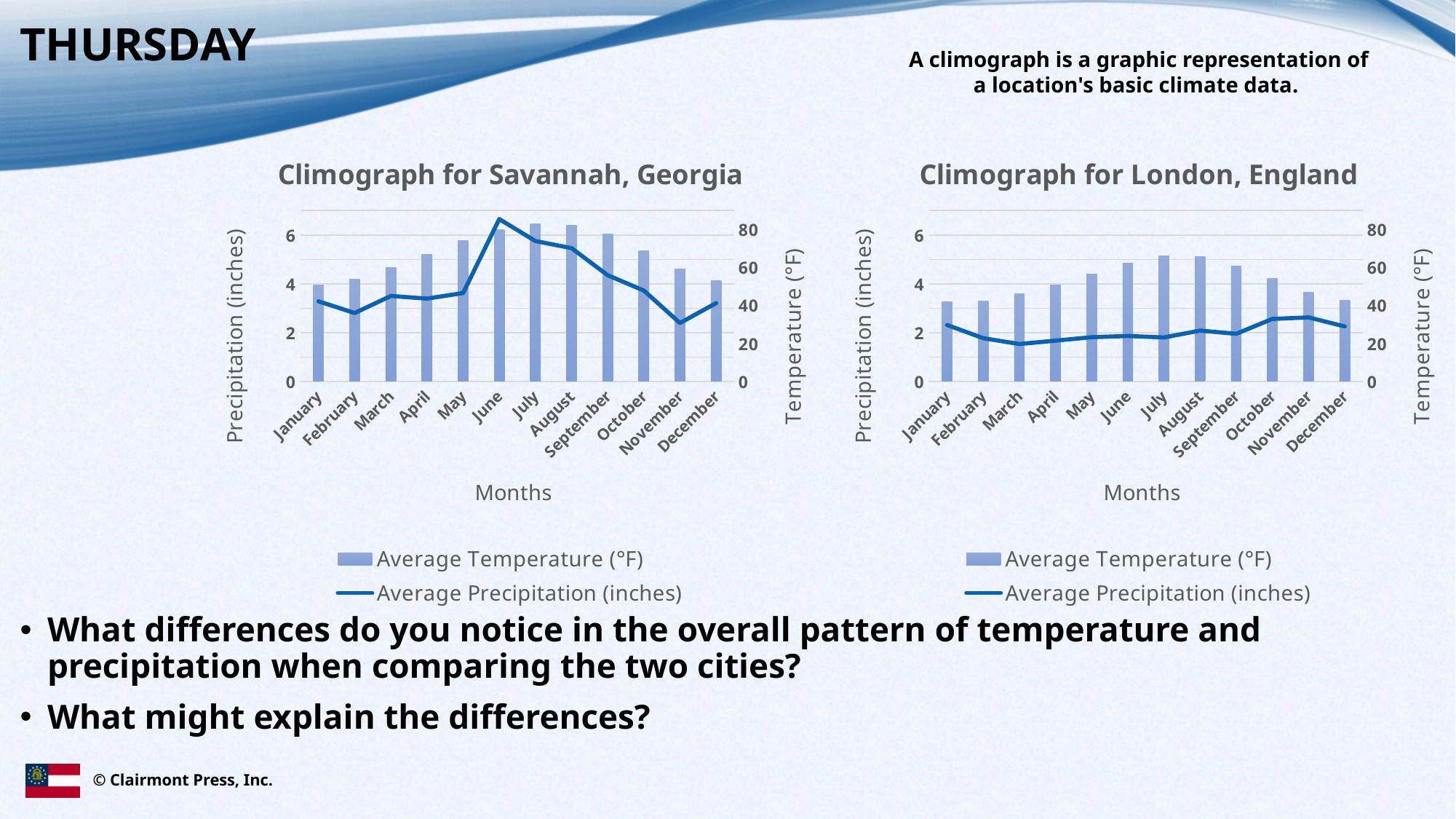
What kind of chart is the Climograph for London, England? Combined bar and line chart In the Climograph for Savannah, Georgia, which month has the highest average precipitation? June In the Climograph for Savannah, Georgia, does the average temperature rise or fall from January to July? rise In the Climograph for Savannah, Georgia, which month has the lowest average precipitation? November In the Climograph for Savannah, Georgia, is the average precipitation for June greater or less than 6 inches? greater Which chart shows the higher average precipitation for June, the Climograph for Savannah, Georgia or the Climograph for London, England? Climograph for Savannah, Georgia In the Climograph for London, England, is the average temperature for July greater or less than 60°F? greater How many series does the legend of the Climograph for Savannah, Georgia list? 2 How many months are plotted on the x axis of the Climograph for London, England? 12 In the Climograph for Savannah, Georgia, is the average temperature for January greater or less than 40°F? greater In the Climograph for Savannah, Georgia, which series is drawn as a line? Average Precipitation (inches)